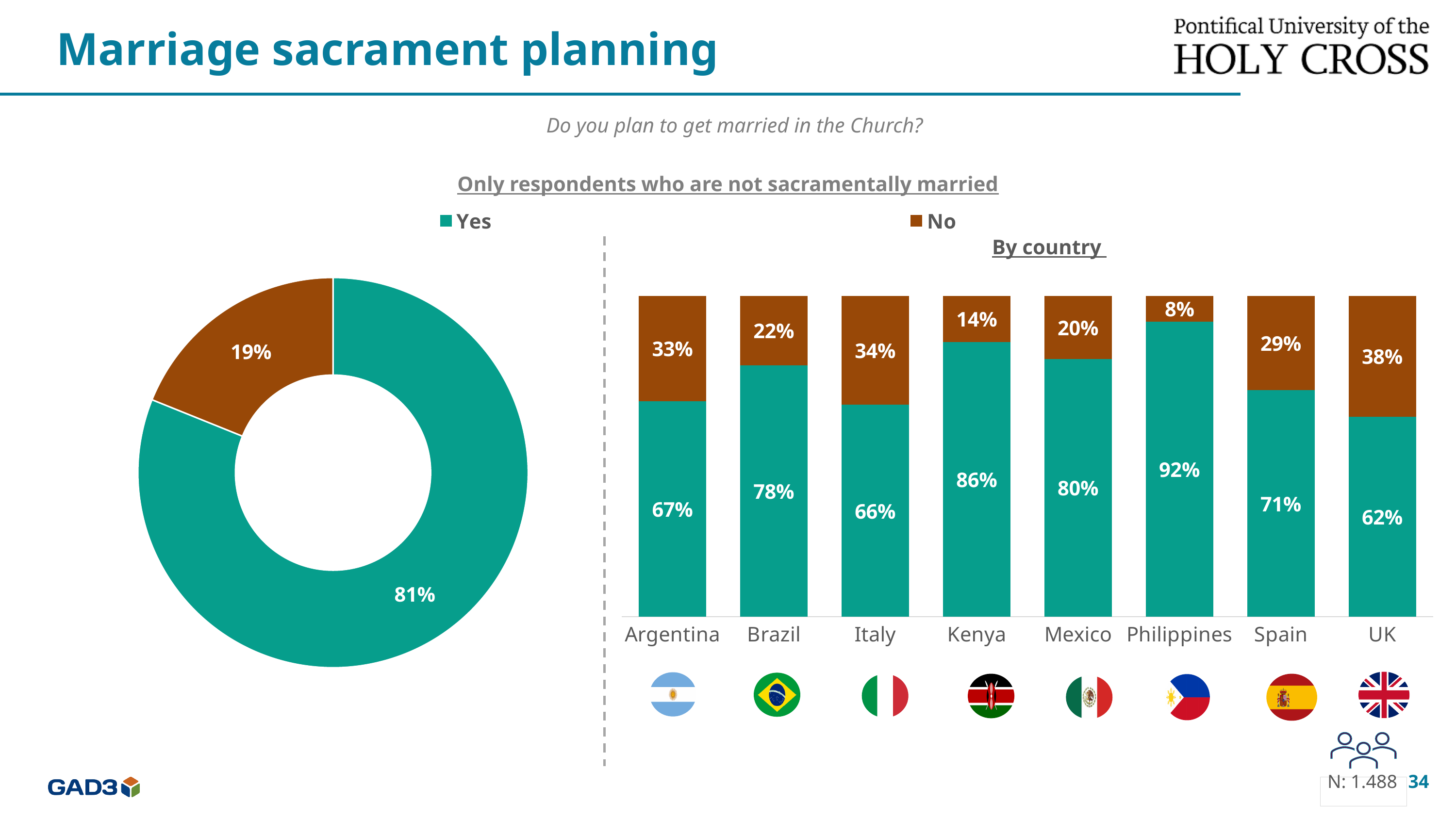
In the 'By country' bar chart, which country has the lowest Yes value? UK In the 'By country' bar chart, which country has the highest Yes value? Philippines In the donut chart on the left, what share of respondents answered Yes? 81% In the 'By country' bar chart, what is the difference between the Yes values for Brazil and Spain? 7% How many countries are shown in the 'By country' bar chart? 8 In the 'By country' bar chart, what is the No value for the UK? 38% In the 'By country' bar chart, what is the Yes value for Kenya? 86% In the 'By country' bar chart, which has a larger No value, Italy or Mexico? Italy In the donut chart on the left, what share of respondents answered No? 19% How many series does the legend list? 2 What kind of chart is the 'By country' chart on the right? Stacked bar chart What is the total of the stacked bar for Argentina in the 'By country' chart? 100%